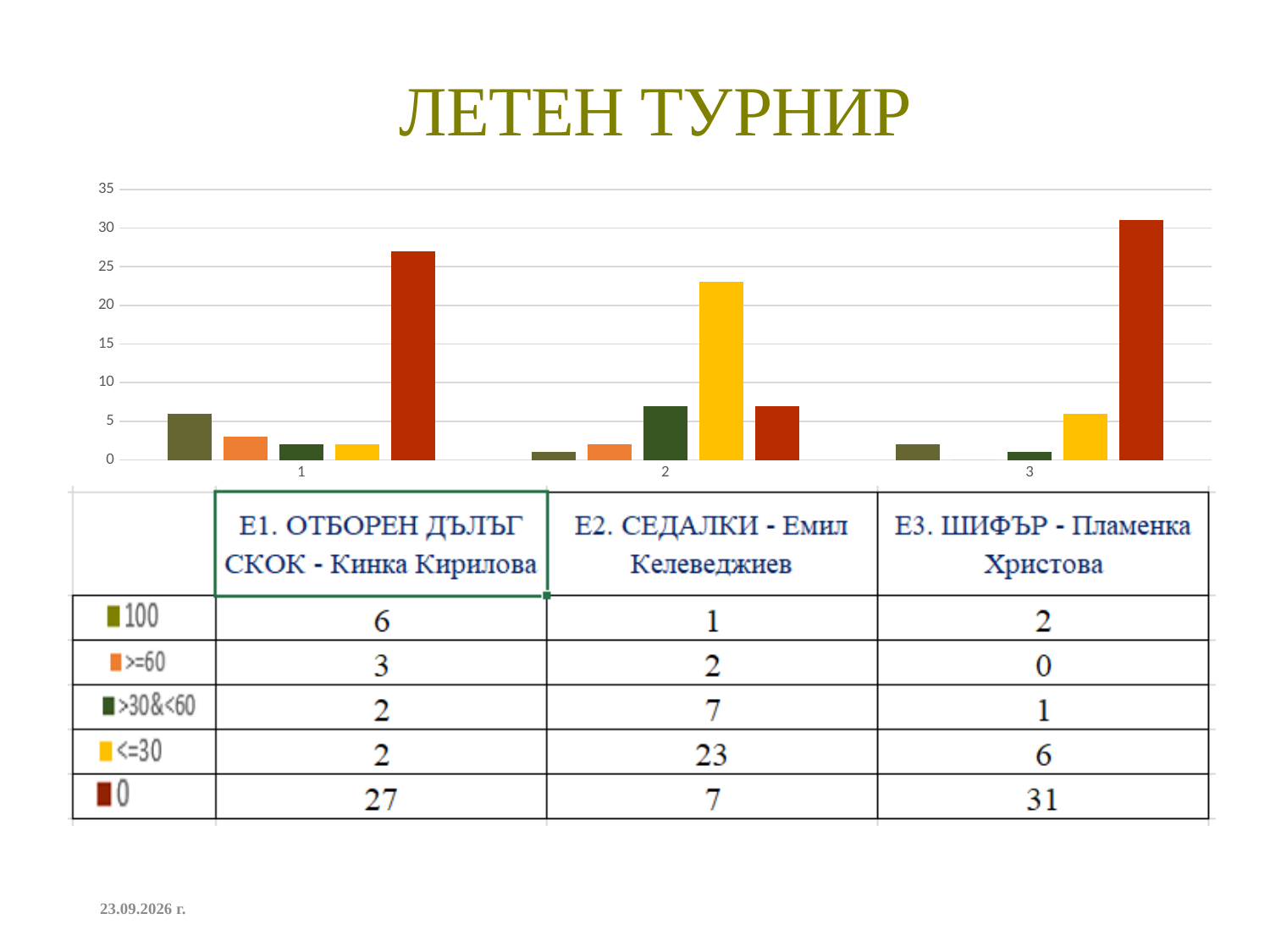
Is the value of the "0" series for category 1 greater or less than 25? greater How many series does the legend (data table) list? 5 How many categories are shown along the x axis? 3 What kind of chart is shown on the slide? bar chart What is the value of the "0" series for category 3 (Е3. ШИФЪР - Пламенка Христова)? 31 What is the title of the slide above the chart? ЛЕТЕН ТУРНИР Which category has the lowest value for the ">=60" series? 3 (Е3. ШИФЪР - Пламенка Христова) Which is larger: the "<=30" value for category 2 or the "0" value for category 2? <=30 (23) What is the value of the "<=30" series for category 2 (Е2. СЕДАЛКИ - Емил Келеведжиев)? 23 What is the value of the "100" series for category 1 (Е1. ОТБОРЕН ДЪЛЪГ СКОК - Кинка Кирилова)? 6 Which category has the highest value for the "0" series? 3 (Е3. ШИФЪР - Пламенка Христова) What is the difference between the "0" series values for category 3 and category 1? 4